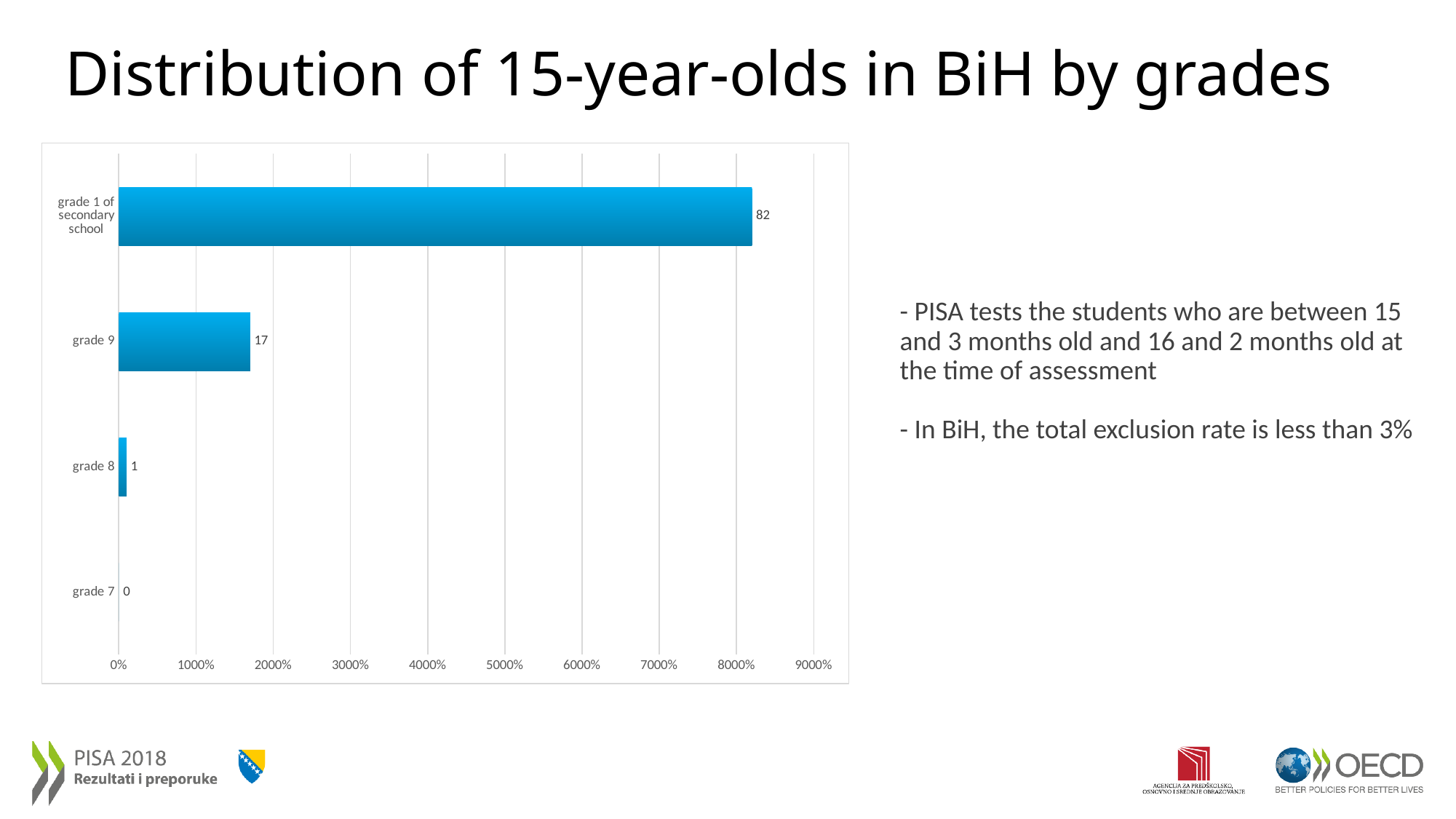
Which grade category has the lowest value? grade 7 Which grade category has the highest value? grade 1 of secondary school What is the difference between the values for grade 1 of secondary school and grade 9? 65 What is the value shown for grade 7? 0 What is the value shown for grade 8? 1 What is the difference between the values for grade 9 and grade 8? 16 What is the value shown for grade 9? 17 What kind of chart is shown on the slide? bar chart What is the value shown for grade 1 of secondary school? 82 Which has a larger value, grade 9 or grade 8? grade 9 What is the title of the slide containing the chart? Distribution of 15-year-olds in BiH by grades How many grade categories are shown in the chart? 4